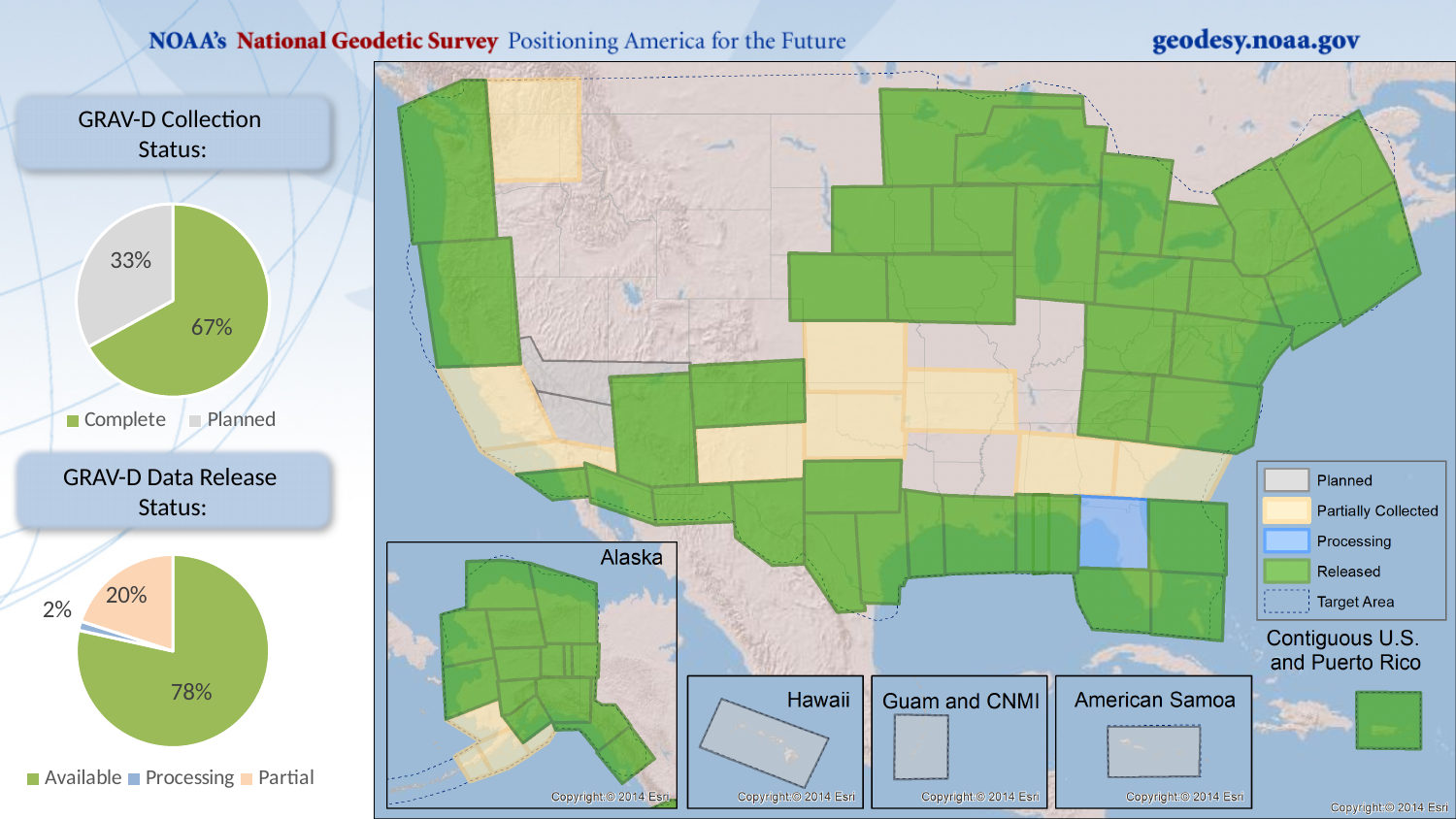
In the GRAV-D Collection Status chart, which category has the larger share? Complete In the GRAV-D Data Release Status chart, what is the difference between the Available and Partial shares? 58% In the GRAV-D Collection Status chart, what share is Complete? 67% In the GRAV-D Data Release Status chart, what share is Processing? 2% In the GRAV-D Data Release Status chart, what share is Available? 78% In the GRAV-D Data Release Status chart, what share is Partial? 20% In the GRAV-D Data Release Status chart, which category has the smallest share? Processing In the GRAV-D Collection Status chart, what is the difference between the Complete and Planned shares? 34% How many categories does the legend of the GRAV-D Collection Status chart list? 2 In the GRAV-D Collection Status chart, what share is Planned? 33% What kind of chart is the GRAV-D Collection Status chart? Pie chart How many slices does the GRAV-D Data Release Status pie chart have? 3